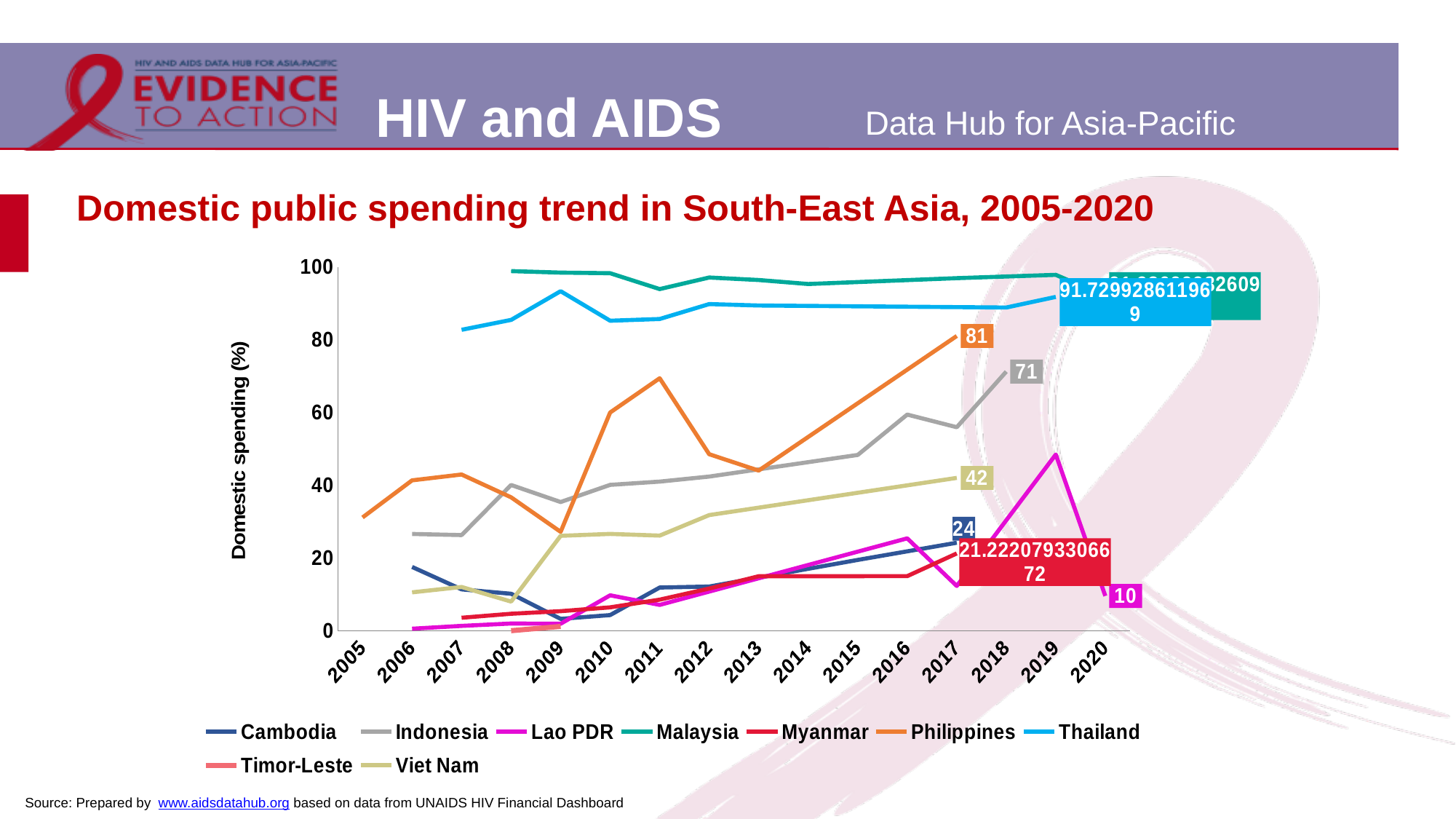
How many series does the legend list? 9 Is the value for Thailand in 2009 greater or less than 80? greater What is the labelled value for Lao PDR in 2020? 10 What is the labelled value at the end of the Viet Nam line? 42 What is the title of the y-axis? Domestic spending (%) What is the labelled value at the end of the Indonesia line? 71 What is the labelled value at the end of the Philippines line? 81 What is the labelled value at the end of the Cambodia line? 24 What is the difference between the final labelled values of the Philippines (81) and Indonesia (71)? 10 Does the Philippines line rise or fall between 2013 and 2017? rise What type of chart is shown on the slide? line chart Which country's line is the highest across the chart? Malaysia